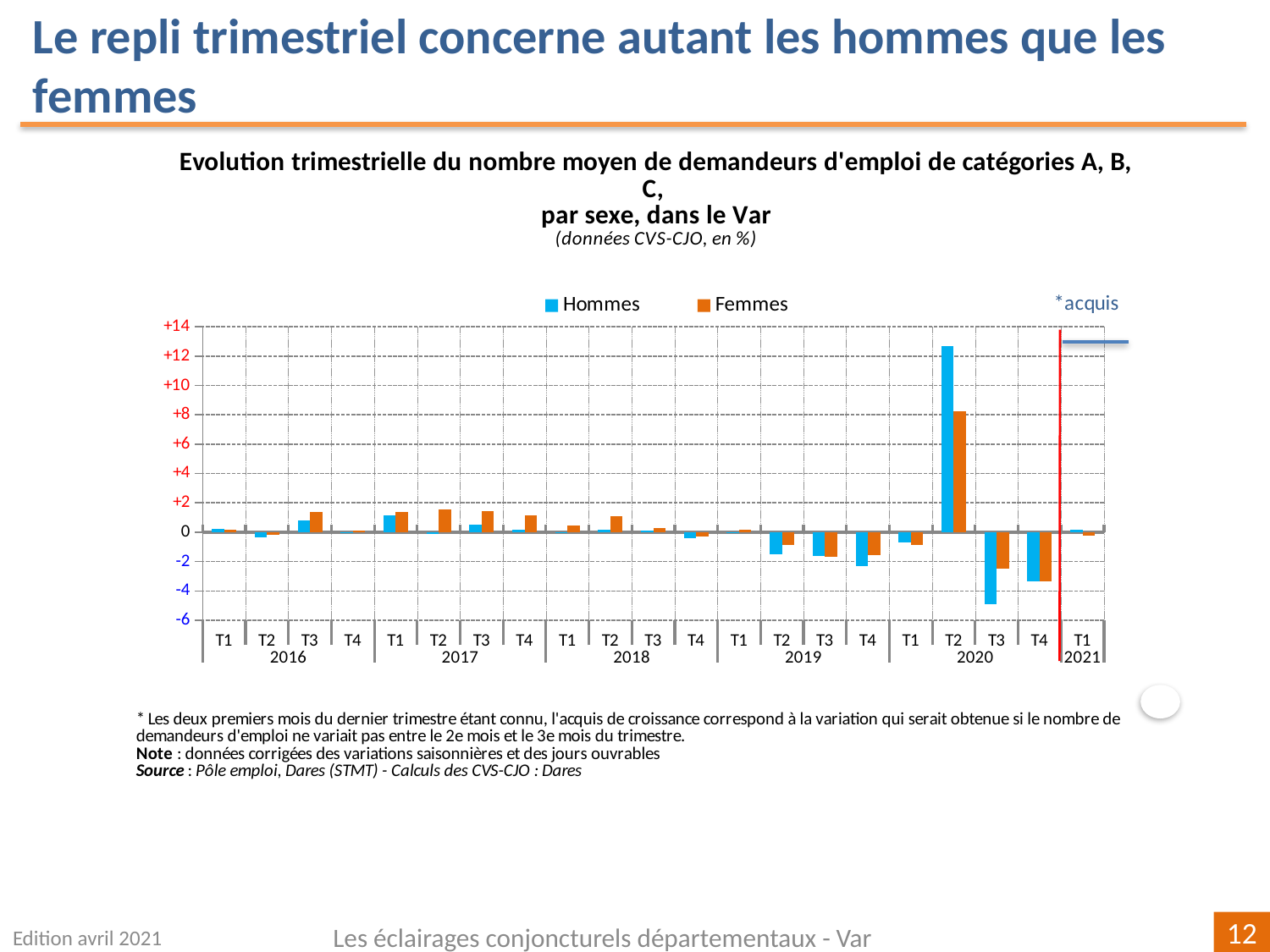
In T2 2020, which series has the larger value, Hommes or Femmes? Hommes How many series does the legend list? 2 Which two series are shown in the legend? Hommes and Femmes How many quarters are plotted along the x axis? 21 Is the Femmes value for T2 2020 greater or less than +6? greater In which quarter is the Hommes bar highest? T2 2020 In which quarter is the Hommes bar lowest? T3 2020 What colour are the bars for the Femmes series? orange Is the Hommes value for T2 2020 greater or less than +10? greater Is the Hommes value for T3 2020 greater or less than -4? less What kind of chart is shown on the slide? bar chart In which quarter is the Femmes bar highest? T2 2020